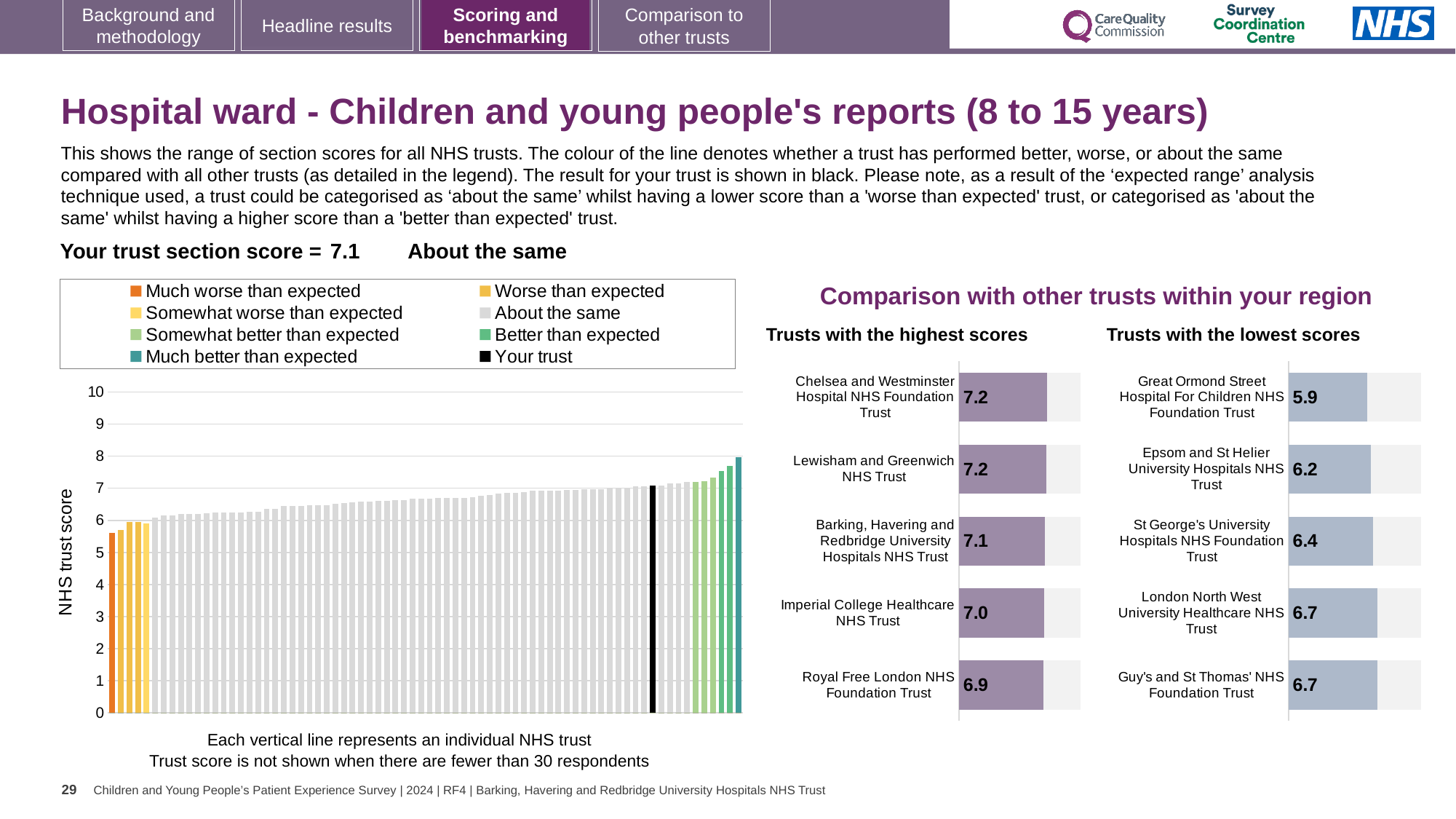
How many entries does the legend of the 'NHS trust score' chart on the left list? 8 In the 'Trusts with the highest scores' chart, what is the score for Chelsea and Westminster Hospital NHS Foundation Trust? 7.2 In the 'Trusts with the lowest scores' chart, what is the score for Great Ormond Street Hospital For Children NHS Foundation Trust? 5.9 In the 'Trusts with the lowest scores' chart, what is the difference between the scores of St George's University Hospitals NHS Foundation Trust and Great Ormond Street Hospital For Children NHS Foundation Trust? 0.5 In the 'Trusts with the highest scores' chart, what is the difference between the scores of Chelsea and Westminster Hospital NHS Foundation Trust and Royal Free London NHS Foundation Trust? 0.3 In the 'Trusts with the lowest scores' chart, what is the score for Epsom and St Helier University Hospitals NHS Trust? 6.2 In the 'Trusts with the lowest scores' chart, which trust has the lowest score? Great Ormond Street Hospital For Children NHS Foundation Trust In the 'NHS trust score' chart on the left, do the bars rise or fall from left to right? Rise In the 'Trusts with the highest scores' chart, what is the score for Royal Free London NHS Foundation Trust? 6.9 In the 'Trusts with the highest scores' chart, which has the higher score: Imperial College Healthcare NHS Trust or Royal Free London NHS Foundation Trust? Imperial College Healthcare NHS Trust What kind of chart is the 'NHS trust score' chart on the left of the slide? Bar chart How many trusts are listed in the 'Trusts with the highest scores' chart? 5